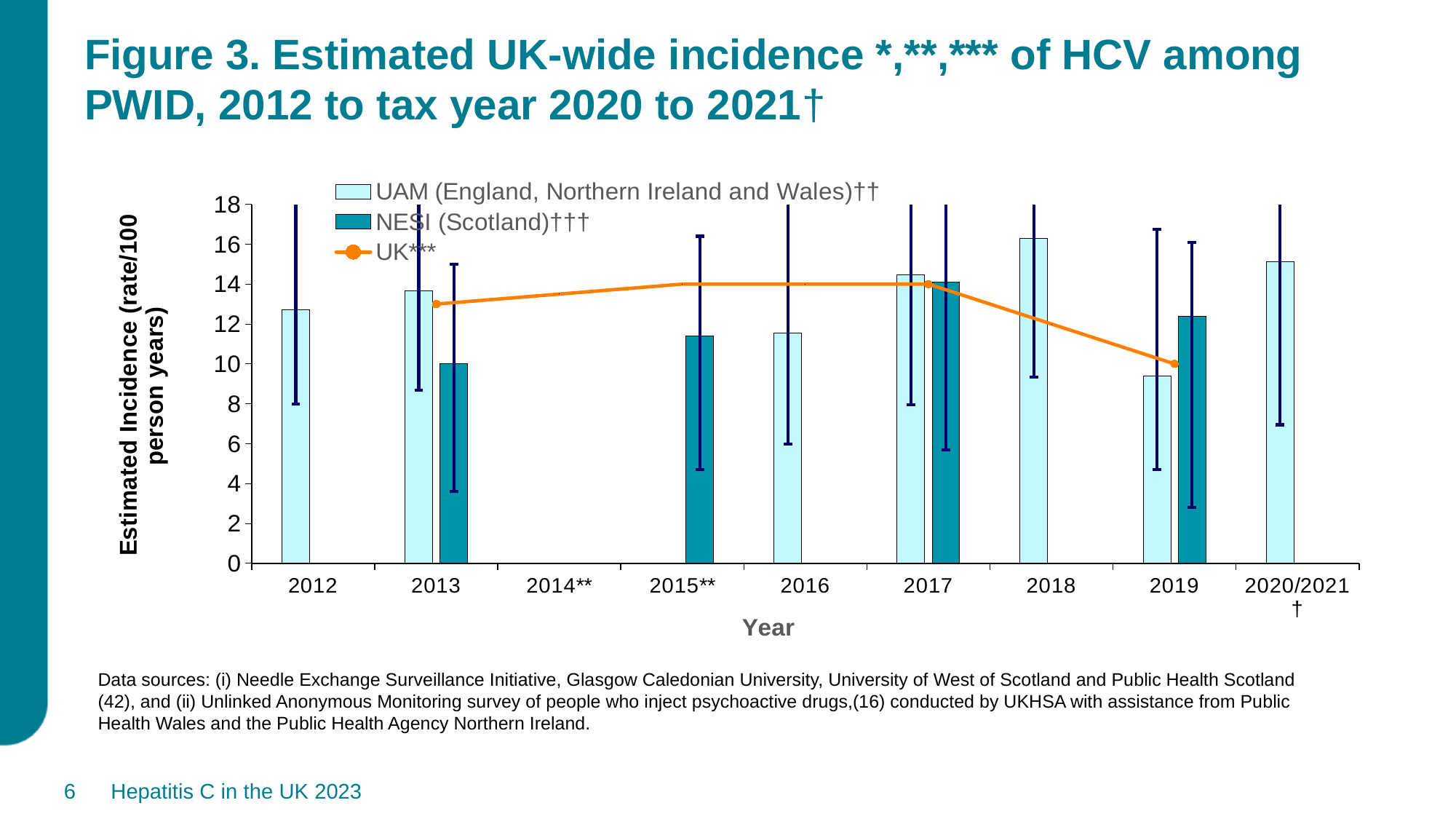
What kind of chart is shown on the slide? A bar chart combined with a line Which year has the lowest UAM (England, Northern Ireland and Wales) bar? 2019 Is the NESI (Scotland) value for 2015** greater or less than 12? less Does the UK*** line rise or fall between 2017 and 2019? Fall How many series does the legend list? 3 Is the UAM (England, Northern Ireland and Wales) value for 2019 greater or less than 10? less How many year categories are shown on the x axis? 9 Is the UAM (England, Northern Ireland and Wales) value for 2018 greater or less than 14? greater What is the label of the y axis? Estimated Incidence (rate/100 person years) Which year has the highest UAM (England, Northern Ireland and Wales) bar? 2018 Which year has the highest NESI (Scotland) bar? 2017 In 2019, which is larger: the UAM (England, Northern Ireland and Wales) bar or the NESI (Scotland) bar? NESI (Scotland)